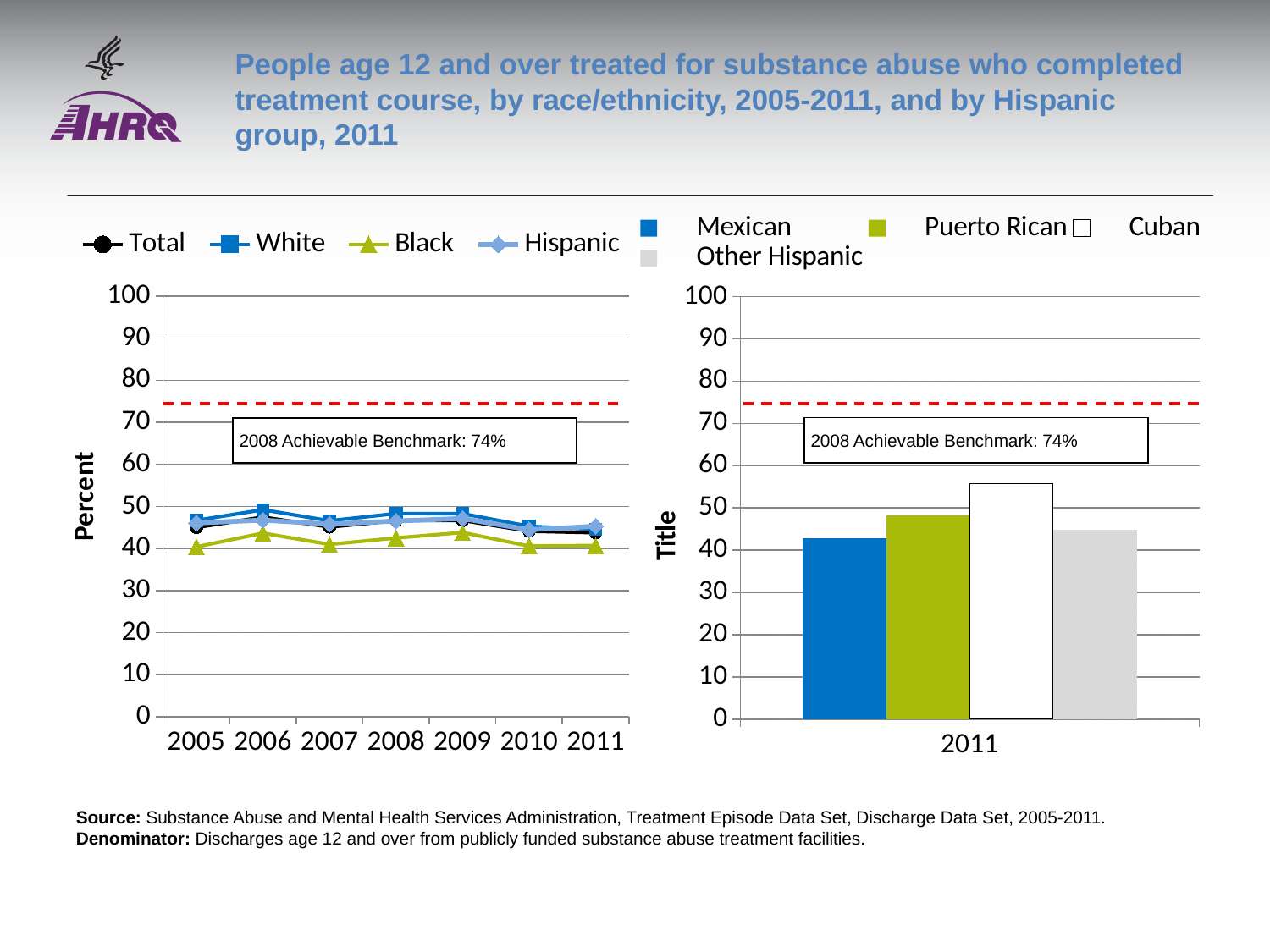
How many years are shown on the x axis of the left chart? 7 In the right chart, which Hispanic group has the highest value in 2011? Cuban In the right chart, is the value for Cuban greater or less than 50? greater What kind of chart is the left chart showing race/ethnicity from 2005 to 2011? line chart What kind of chart is the right chart showing Hispanic groups in 2011? bar chart In the left chart, is the value for Black in 2005 greater or less than 50? less In the right chart, which is larger, the value for Puerto Rican or the value for Mexican? Puerto Rican What is the 2008 achievable benchmark shown by the dashed line on both charts? 74% In the right chart, which Hispanic group has the lowest value in 2011? Mexican How many series does the legend of the left chart list? 4 How many Hispanic groups are shown in the right chart? 4 In the left chart, which race/ethnicity group has the lowest values across the years? Black